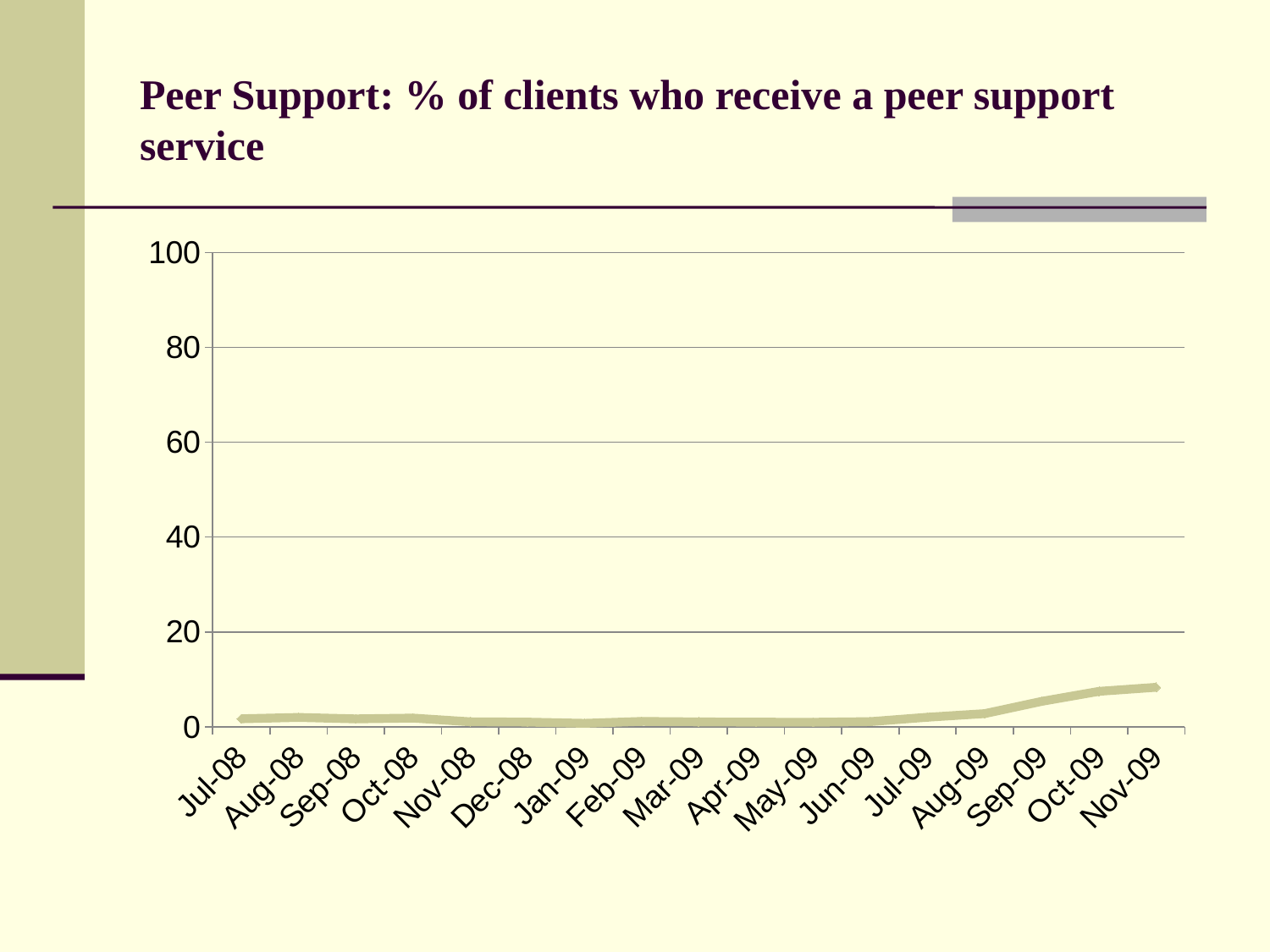
What is the first month shown on the x axis? Jul-08 What kind of chart is shown on the slide? line chart Is the value for Jul-08 greater or less than 20? less Which is larger, the value for Oct-09 or the value for Jan-09? Oct-09 Is the value for Nov-09 greater or less than 20? less Do the values rise or fall from Jul-09 to Nov-09? rise What is the title of the slide? Peer Support: % of clients who receive a peer support service Which is larger, the value for Nov-09 or the value for Jul-08? Nov-09 What is the highest value shown on the y axis? 100 Is the value for Oct-09 greater or less than 40? less Which month has the highest value? Nov-09 How many months are plotted along the x axis? 17